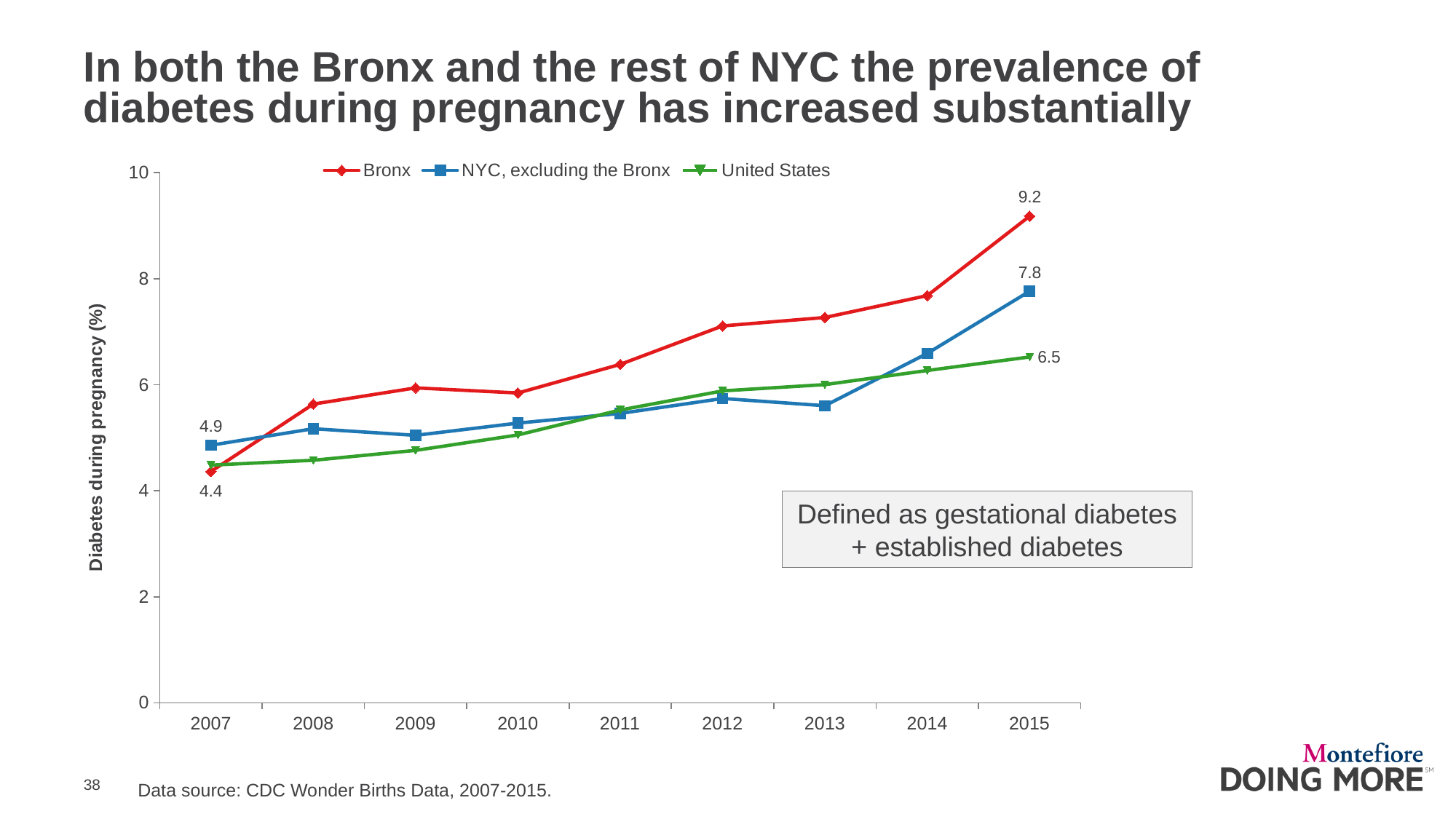
What is the value for the United States in 2015? 6.5 What is the value for the Bronx in 2015? 9.2 In 2007, which was higher: the Bronx or NYC, excluding the Bronx? NYC, excluding the Bronx What kind of chart is shown on the slide? line chart What is the value for NYC, excluding the Bronx in 2007? 4.9 How many series does the legend list? 3 What is the value for the Bronx in 2007? 4.4 How many years are shown on the x axis? 9 Which series has the highest value in 2015? Bronx Is the value for the Bronx in 2012 greater or less than 6? greater What is the difference between the Bronx and NYC, excluding the Bronx in 2015? 1.4 By how much did the Bronx value increase from 2007 to 2015? 4.8